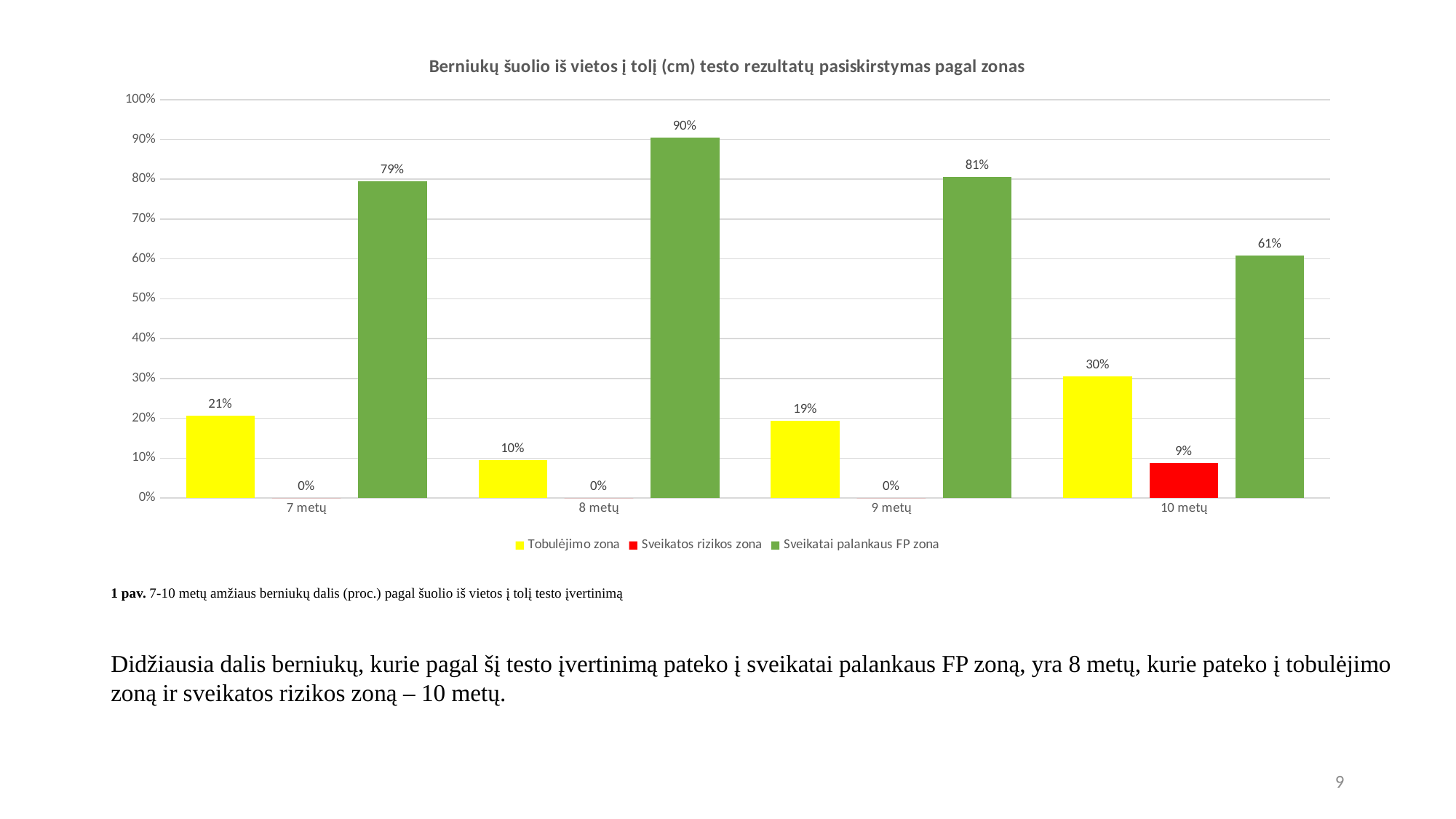
What is the title of the chart? Berniukų šuolio iš vietos į tolį (cm) testo rezultatų pasiskirstymas pagal zonas What kind of chart is shown on the slide? Bar chart What is the value for Sveikatos rizikos zona for 10 metų? 9% Which is larger: Tobulėjimo zona for 7 metų or Tobulėjimo zona for 9 metų? 7 metų What is the value for Tobulėjimo zona for 10 metų? 30% What colour represents Sveikatos rizikos zona in the chart? Red What is the value for Sveikatai palankaus FP zona for 8 metų? 90% What is the difference between the Sveikatai palankaus FP zona values for 9 metų and 10 metų? 20% Which age group has the lowest value for Tobulėjimo zona? 8 metų How many series does the legend list? 3 Which age group has the highest value for Sveikatai palankaus FP zona? 8 metų How many age groups are shown on the x axis? 4